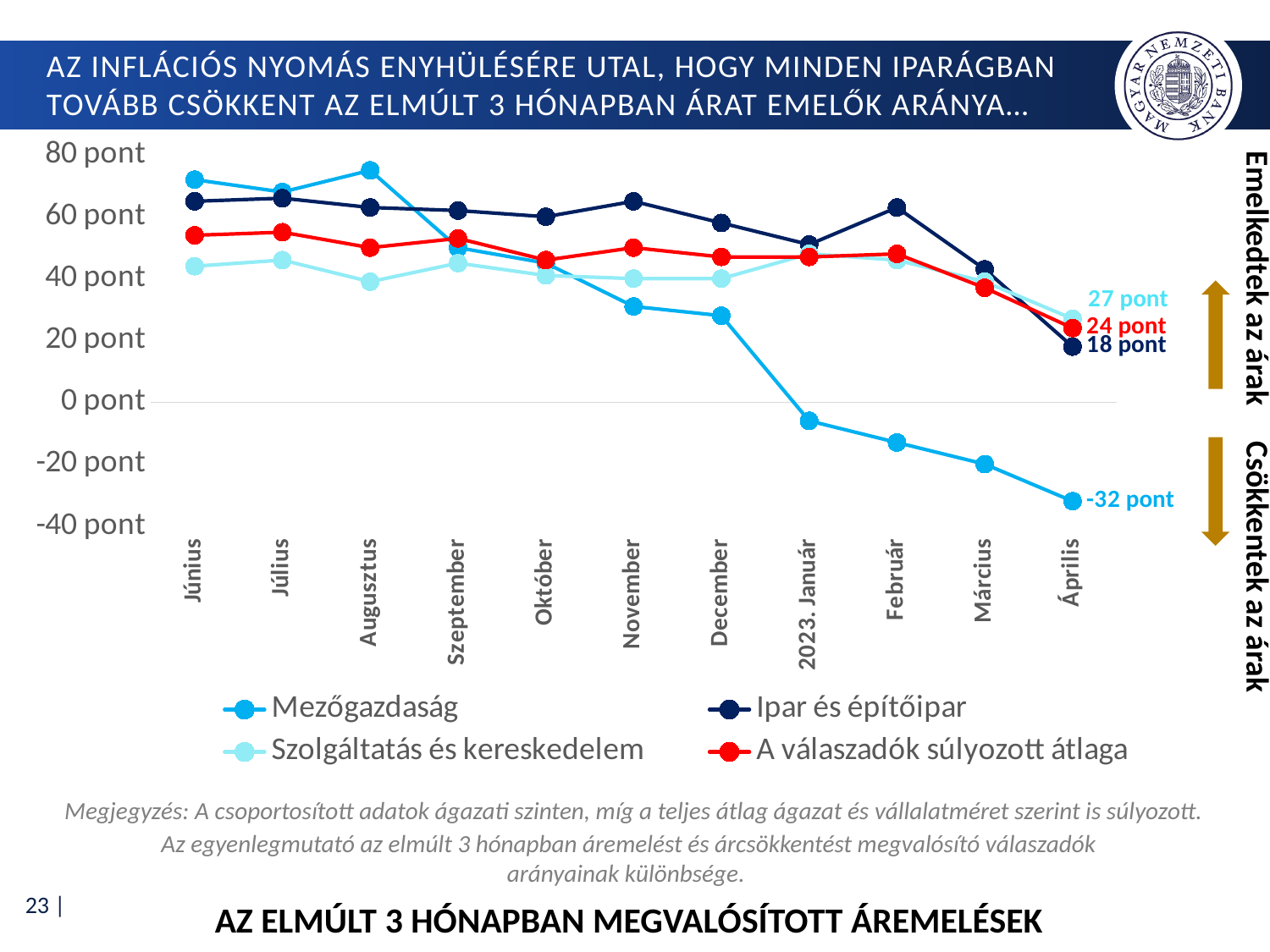
What is the value for Ipar és építőipar in Április? 18 pont In Április, what is the difference between Szolgáltatás és kereskedelem and Mezőgazdaság? 59 pont What is the value for Szolgáltatás és kereskedelem in Április? 27 pont What is the value for A válaszadók súlyozott átlaga in Április? 24 pont What is the value for Mezőgazdaság in Április? -32 pont In Április, how much higher is A válaszadók súlyozott átlaga than Ipar és építőipar? 6 pont Does the Mezőgazdaság series rise or fall from Június to Április? fall How many months are shown along the x axis? 11 How many series does the legend list? 4 Is the value for Mezőgazdaság in Június greater or less than 60 pont? greater Which series has the lowest value in Április? Mezőgazdaság What kind of chart is shown on the slide? line chart